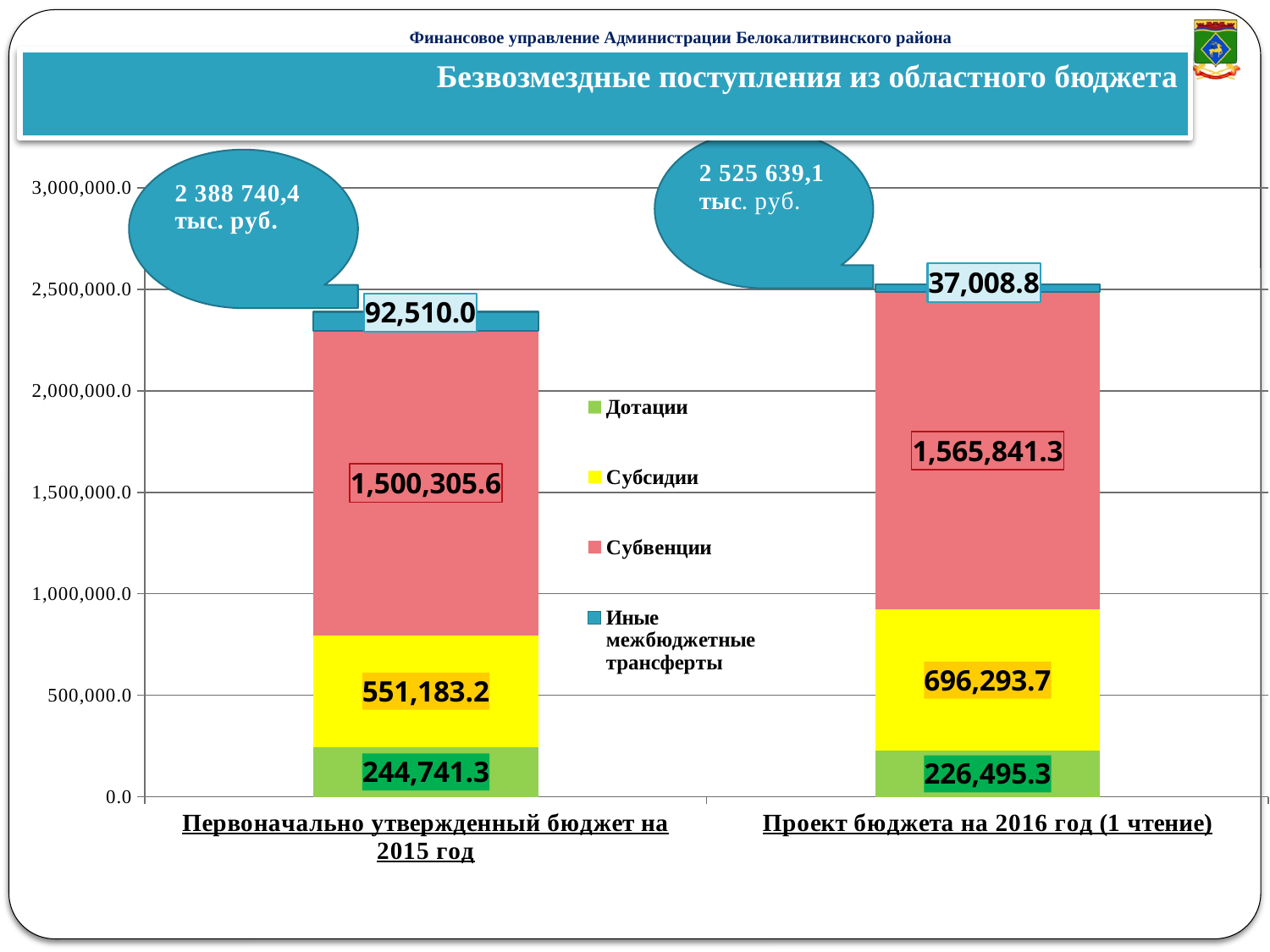
By how much does Субсидии for 2016 exceed Субсидии for 2015? 145,110.5 How many categories (bars) are shown on the x axis? 2 What is the total of the stacked bar for 'Проект бюджета на 2016 год (1 чтение)'? 2,525,639.1 What is the value of Субсидии for 'Проект бюджета на 2016 год (1 чтение)'? 696,293.7 Which series has the largest value in the 'Проект бюджета на 2016 год (1 чтение)' bar? Субвенции Which is larger: Дотации in the 2015 bar or Дотации in the 2016 bar? Дотации in the 2015 bar (244,741.3) What type of chart is shown on the slide? Stacked bar chart How many series does the legend list? 4 What is the value of Субвенции for 'Первоначально утвержденный бюджет на 2015 год'? 1,500,305.6 What is the value of Иные межбюджетные трансферты for 'Проект бюджета на 2016 год (1 чтение)'? 37,008.8 What is the value of Дотации for 'Первоначально утвержденный бюджет на 2015 год'? 244,741.3 Which series has the smallest value in the 'Первоначально утвержденный бюджет на 2015 год' bar? Иные межбюджетные трансферты